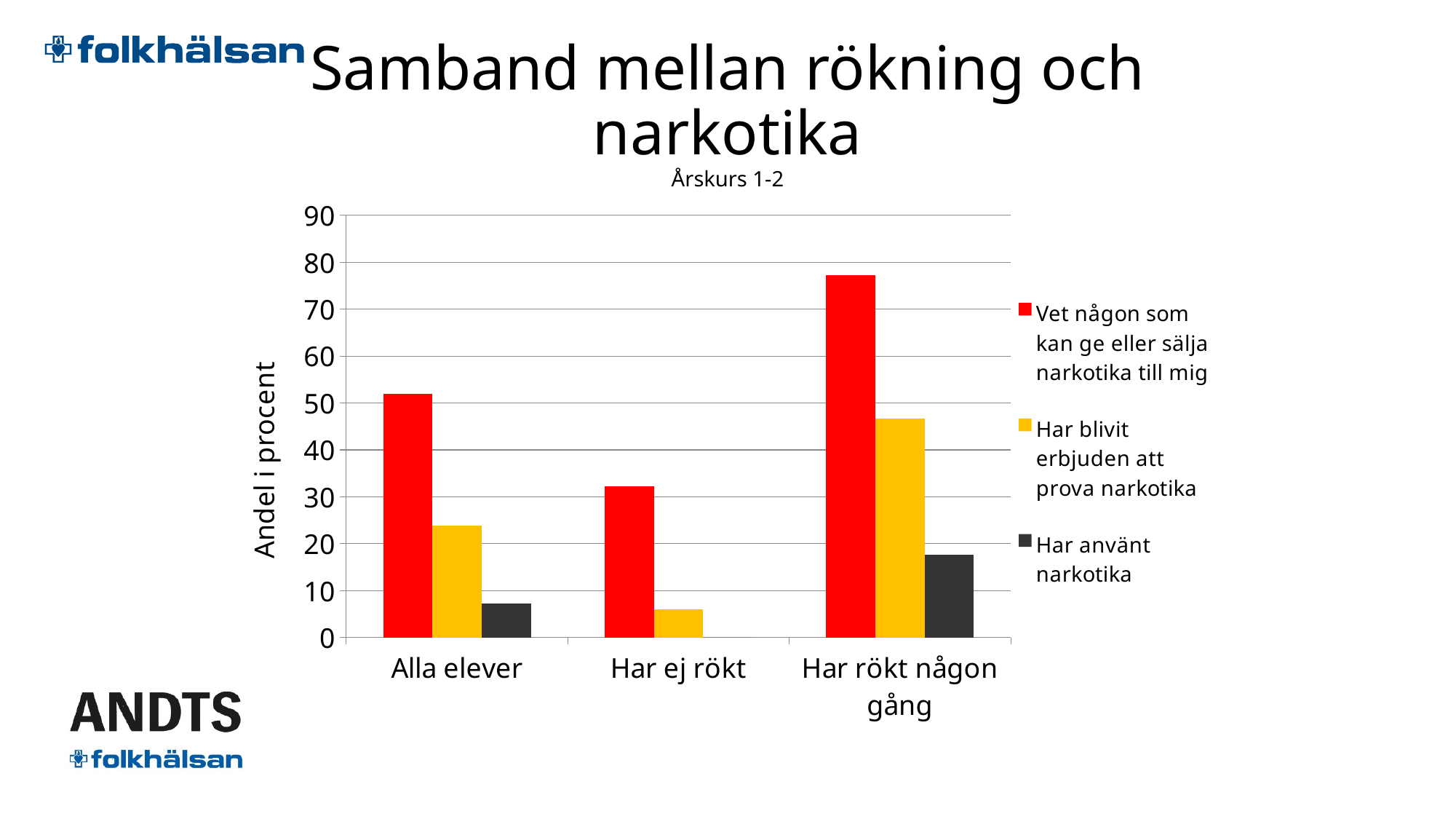
Which is larger for 'Har rökt någon gång': 'Har blivit erbjuden att prova narkotika' or 'Har använt narkotika'? Har blivit erbjuden att prova narkotika Is the value for 'Vet någon som kan ge eller sälja narkotika till mig' in 'Har ej rökt' greater or less than 40? less What is the chart's title? Årskurs 1-2 How many series does the legend list? 3 Which category has the highest value for 'Vet någon som kan ge eller sälja narkotika till mig'? Har rökt någon gång What is the y-axis label? Andel i procent Which is larger: 'Har använt narkotika' for 'Alla elever' or for 'Har rökt någon gång'? Har rökt någon gång Is the value for 'Har blivit erbjuden att prova narkotika' in 'Alla elever' greater or less than 30? less Which category has the lowest value for 'Har blivit erbjuden att prova narkotika'? Har ej rökt How many categories are shown on the x axis? 3 Is the value for 'Vet någon som kan ge eller sälja narkotika till mig' in 'Har rökt någon gång' greater or less than 70? greater What kind of chart is shown on the slide? bar chart